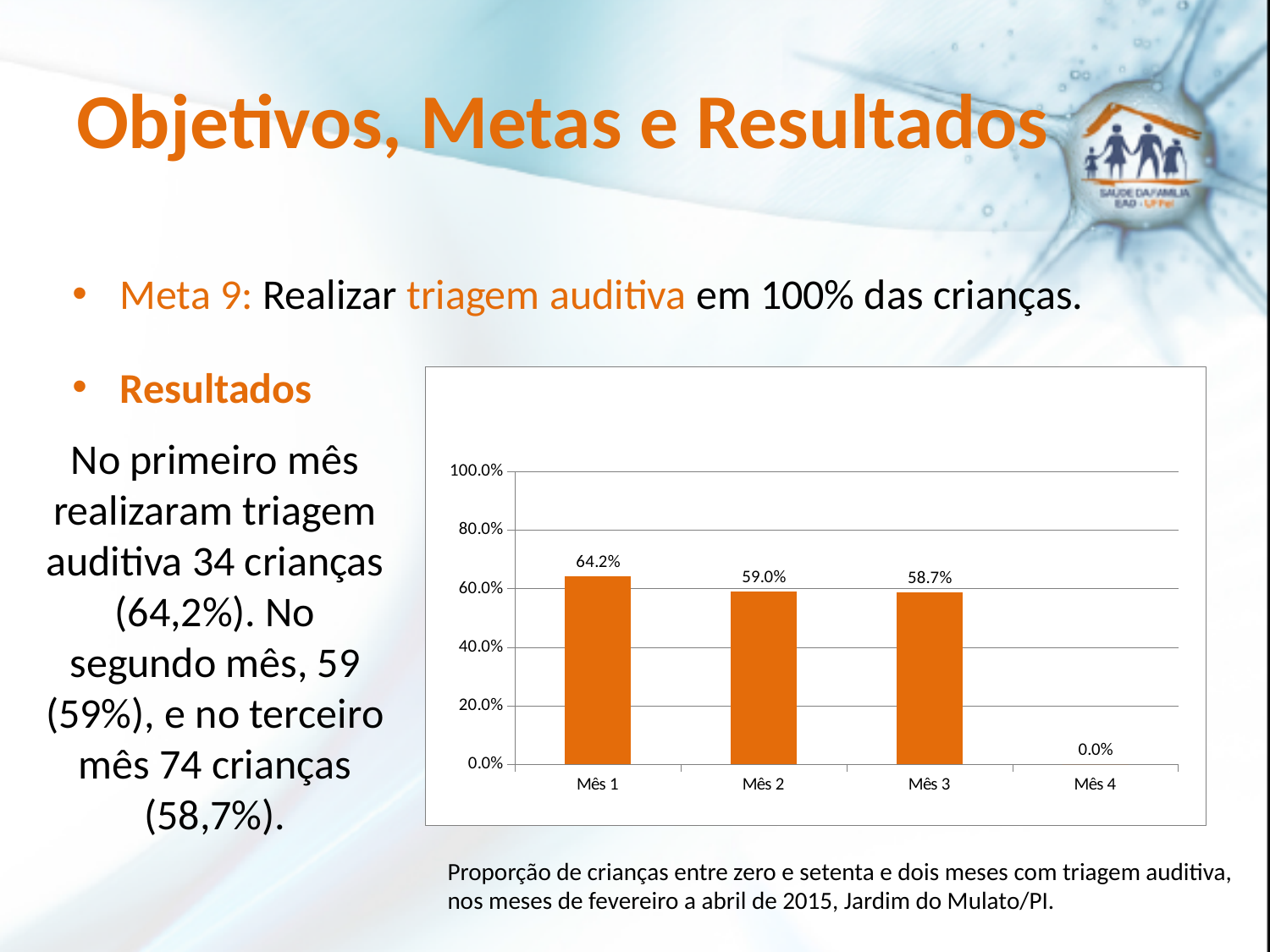
What is the value for Mês 1? 64.2% What kind of chart is shown on the slide? bar chart How many categories are shown on the x axis? 4 Which month has the highest value? Mês 1 Do the values rise or fall from Mês 1 to Mês 4? fall Is the value for Mês 2 greater or less than 60.0%? less Which is larger, the value for Mês 1 or the value for Mês 3? Mês 1 What is the value for Mês 3? 58.7% What is the difference between the values for Mês 2 and Mês 3? 0.3% What is the difference between the values for Mês 1 and Mês 2? 5.2% Which month has the lowest value? Mês 4 What is the value for Mês 4? 0.0%